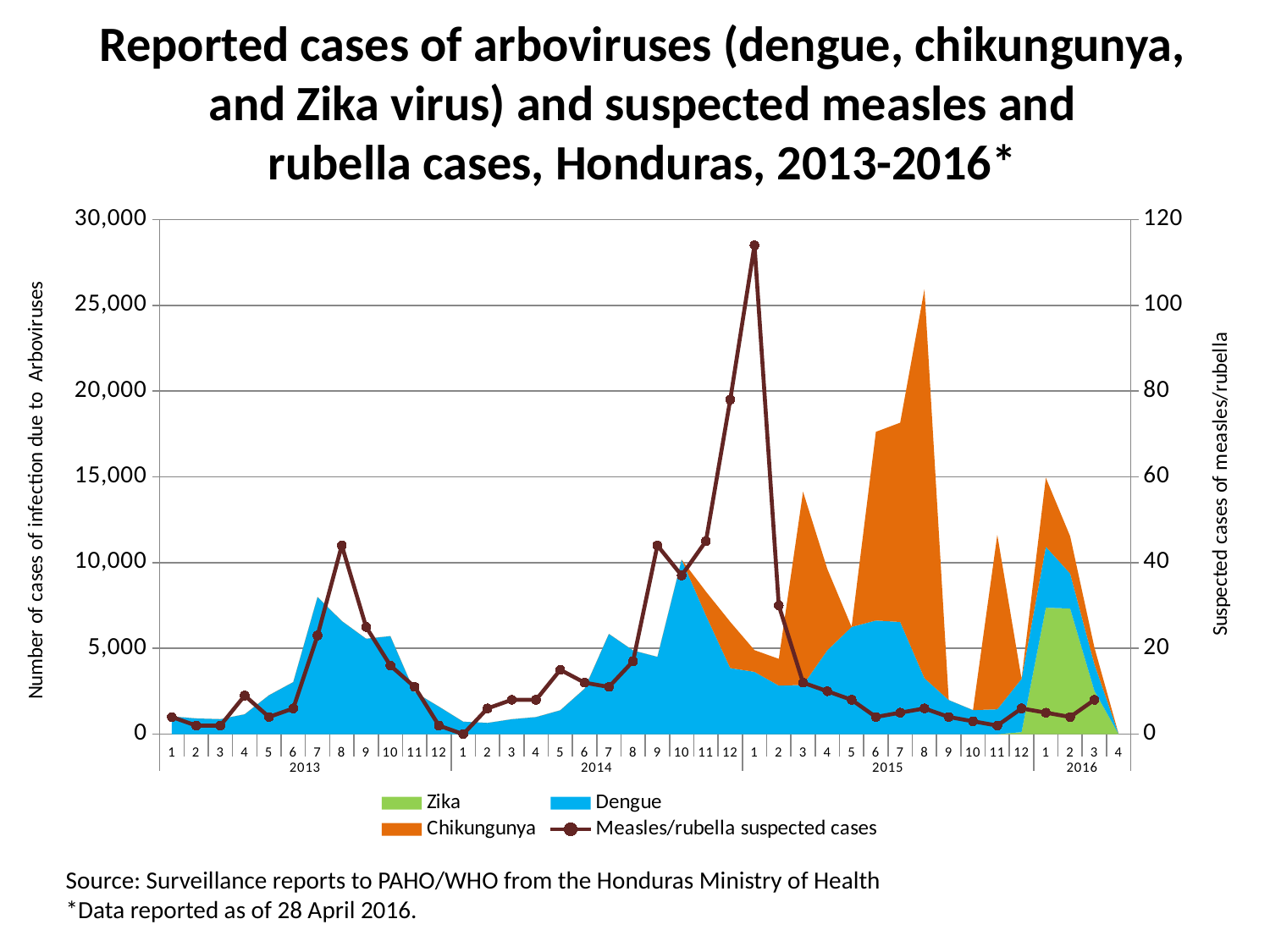
What kind of chart is this? A combined area and line chart Does the Measles/rubella suspected cases line rise or fall between January 2015 and March 2015? fall How many monthly data points are plotted along the x axis? 40 Which series is shown in green? Zika Is the Dengue area in July 2013 greater or less than 10,000 on the left axis? less Is the peak value of the Measles/rubella suspected cases line greater or less than 100 on the right axis? greater In which month and year does the Measles/rubella suspected cases line reach its highest point? January 2015 How many series does the legend list? 4 Is the Measles/rubella suspected cases value in August 2013 greater or less than 40 on the right axis? greater What are the four series listed in the legend? Zika, Dengue, Chikungunya, Measles/rubella suspected cases